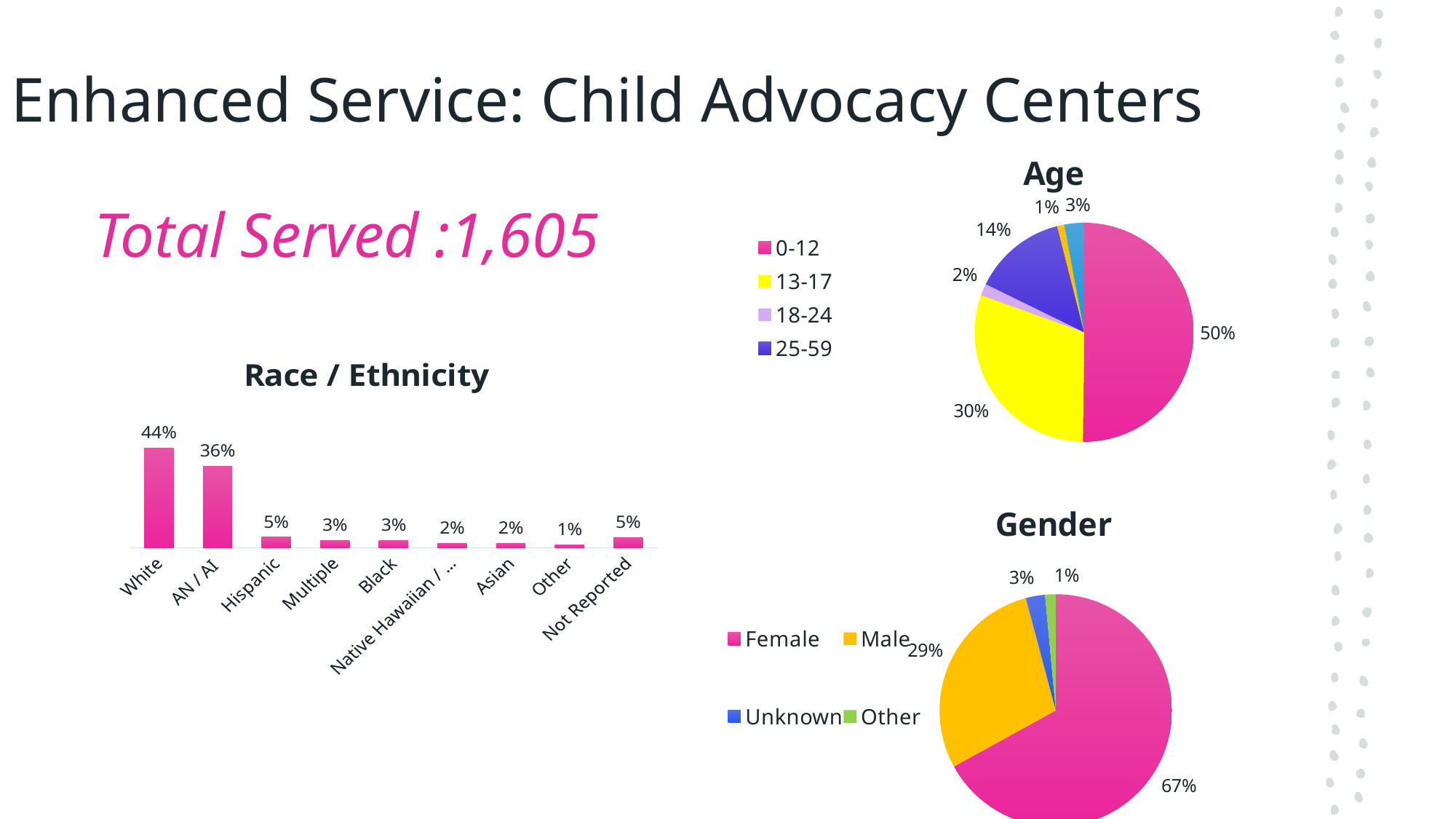
In the Race / Ethnicity chart, which category has the lowest value? Other In the Race / Ethnicity chart, what is the value for White? 44% In the Gender pie chart, which is larger, Male or Unknown? Male In the Age pie chart, what is the value for the 13-17 group? 30% In the Race / Ethnicity chart, what is the difference between the values for White and AN / AI? 8% In the Race / Ethnicity chart, which category has the highest value? White In the Age pie chart, what is the value for the 25-59 group? 14% How many categories are shown in the Race / Ethnicity chart? 9 In the Gender pie chart, what is the value for Female? 67% In the Age pie chart, what share does the 0-12 group have? 50% How many entries does the legend of the Gender chart list? 4 What kind of chart is the Race / Ethnicity chart? Bar chart